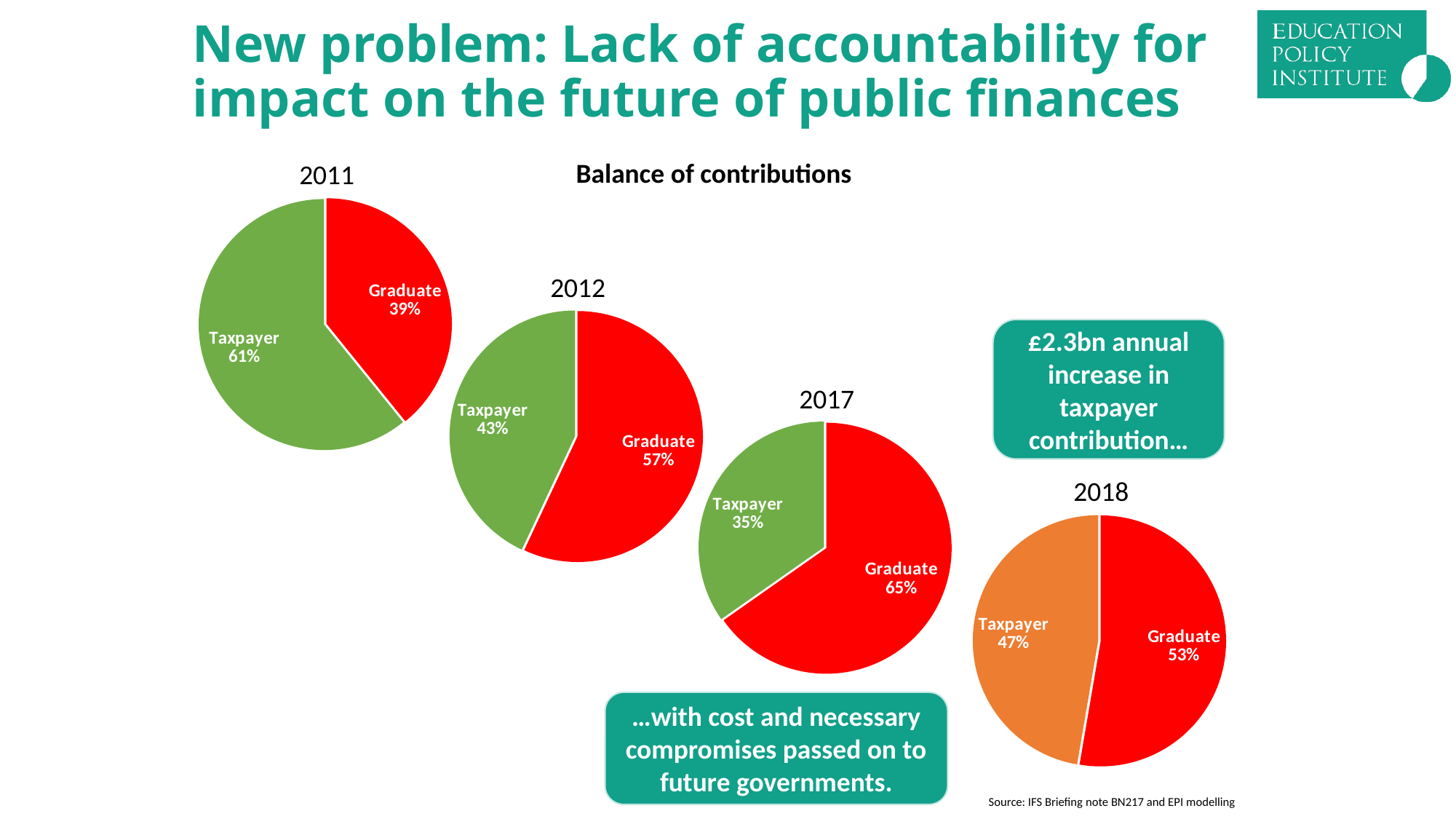
What kind of chart is used to show the balance of contributions for each year? Pie chart What is the title shown above the group of pie charts? Balance of contributions In the 2012 pie chart, what share of contributions comes from the Graduate? 57% In the 2017 pie chart, which slice is larger, Taxpayer or Graduate? Graduate Across the 2011, 2012 and 2017 pie charts, does the Taxpayer share rise or fall over time? Fall In the 2017 pie chart, what is the Taxpayer share? 35% In the 2011 pie chart, what share of contributions comes from the Taxpayer? 61% In the 2011 pie chart, which slice is the largest? Taxpayer In the 2018 pie chart, what is the Graduate share? 53% In the 2012 pie chart, what is the difference between the Graduate and Taxpayer shares? 14% How many pie charts are shown on the slide? 4 In the 2017 pie chart, how many percentage points larger is the Graduate share than the Taxpayer share? 30 percentage points